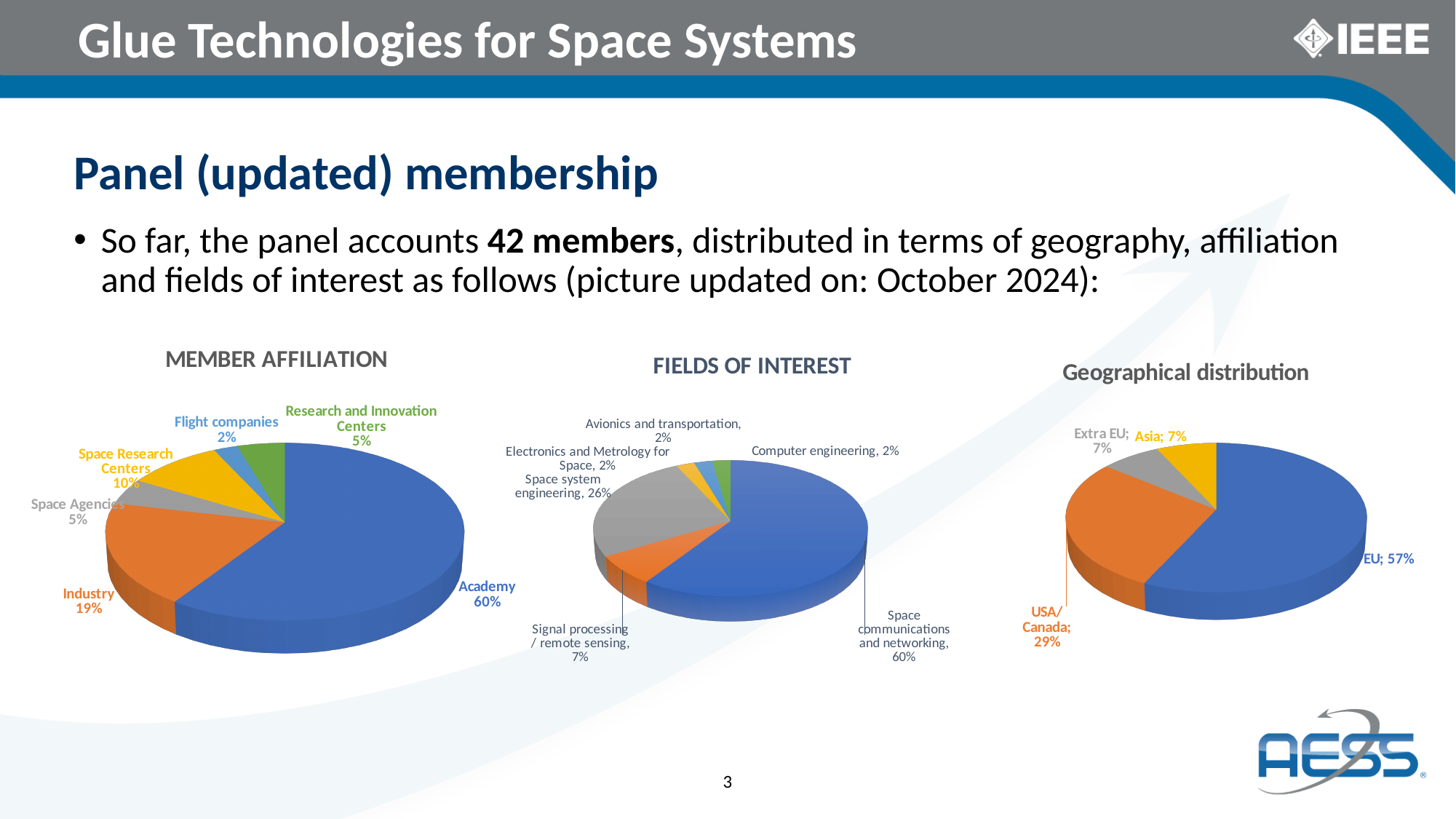
In the MEMBER AFFILIATION chart, what percentage is labelled for Industry? 19% In the Geographical distribution chart, how many regions are shown? 4 What type of chart is used for the Geographical distribution? Pie chart In the MEMBER AFFILIATION chart, how many slices does the pie have? 6 In the FIELDS OF INTEREST chart, which field has the largest share? Space communications and networking In the Geographical distribution chart, what share is EU? 57% In the FIELDS OF INTEREST chart, what share is Space system engineering? 26% In the FIELDS OF INTEREST chart, what percentage is Signal processing / remote sensing? 7% In the MEMBER AFFILIATION chart, what share of members are from Academy? 60% In the MEMBER AFFILIATION chart, what is the difference between the Industry and Space Research Centers shares? 9% In the MEMBER AFFILIATION chart, which category has the smallest share? Flight companies In the Geographical distribution chart, which is larger, USA/Canada or Extra EU? USA/Canada